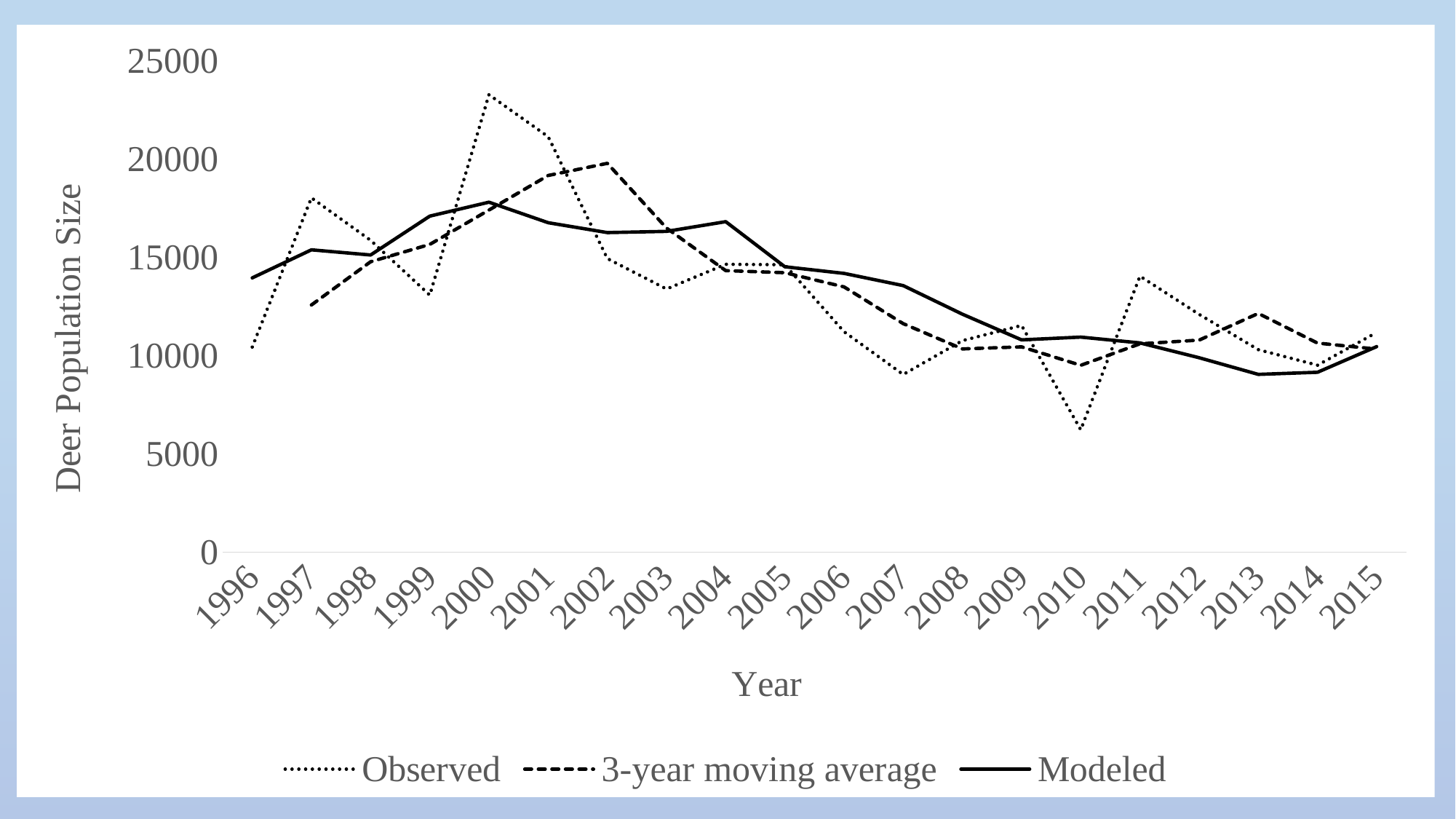
Is the Observed value for 2000 greater or less than 20000? greater In which year does the Modeled series reach its highest value? 2000 Which series has the higher value in 2010, Observed or Modeled? Modeled How many series does the legend list? 3 Is the Modeled value for 2013 greater or less than 10000? less In which year does the Observed series reach its highest value? 2000 How many years are shown along the x axis? 20 Does the Modeled series rise or fall from 2004 to 2013? fall What is the title of the y axis? Deer Population Size In which year does the Observed series reach its lowest value? 2010 What kind of chart is shown on the slide? line chart Is the Observed value for 2010 greater or less than 10000? less